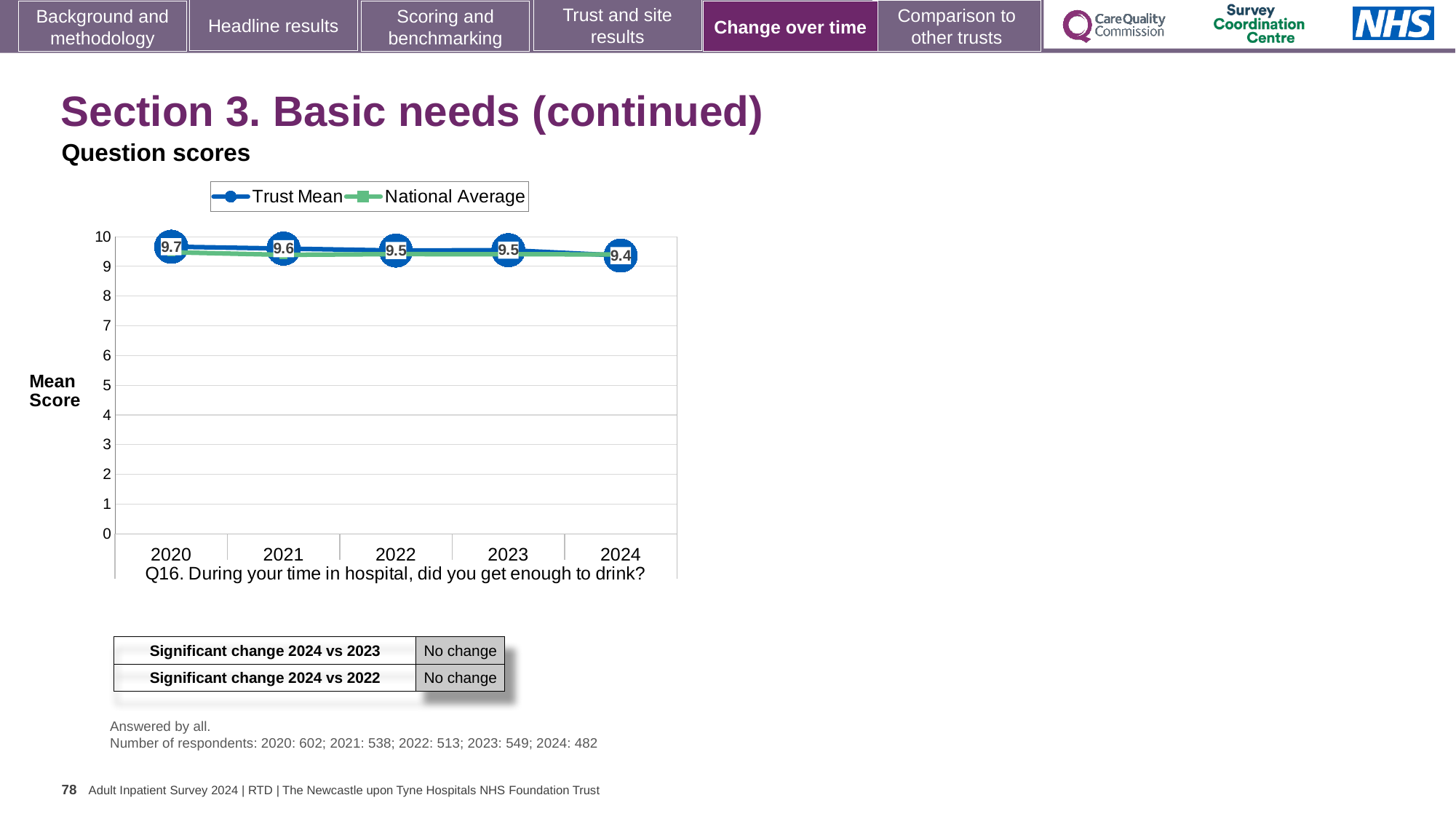
In which year is the Trust Mean highest? 2020 Which is larger, the Trust Mean for 2020 or for 2024? 2020 Is the National Average value for 2022 greater or less than 8? greater How many series does the legend list? 2 What is the Trust Mean score for 2022? 9.5 What is the Trust Mean score for 2024? 9.4 How many years are plotted on the x axis? 5 What is the difference between the Trust Mean in 2020 and in 2024? 0.3 Does the Trust Mean rise or fall from 2020 to 2024? Fall What kind of chart is shown? Line chart What is the Trust Mean score for 2020? 9.7 In which year is the Trust Mean lowest? 2024